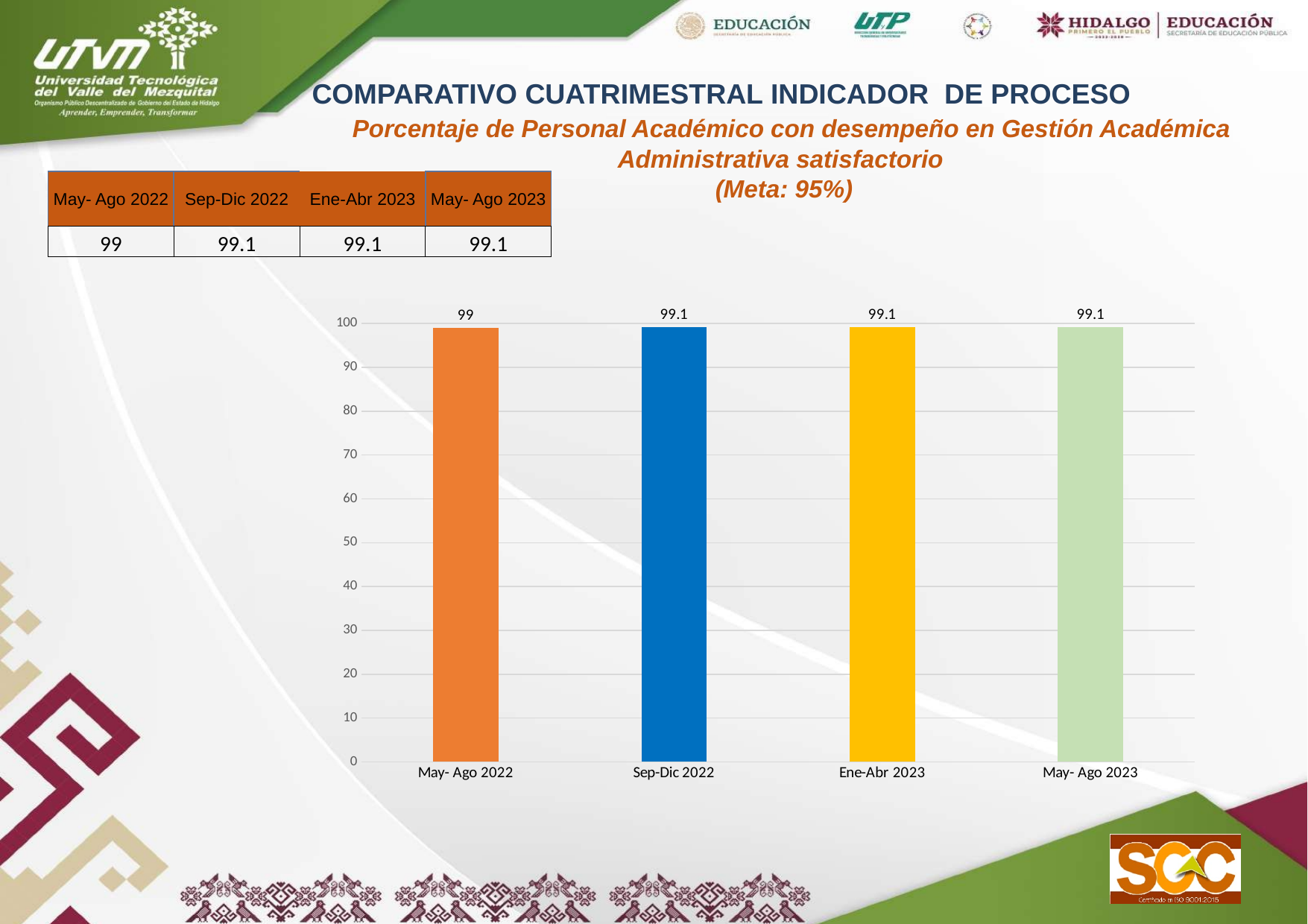
What is the value for Sep-Dic 2022? 99.1 Which is larger, the value for May- Ago 2022 or the value for Sep-Dic 2022? Sep-Dic 2022 Does the value rise or fall from May- Ago 2022 to Sep-Dic 2022? rise What is the value for May- Ago 2022? 99 What colour is the bar for Sep-Dic 2022? blue What is the difference between the values for Sep-Dic 2022 and May- Ago 2022? 0.1 Is the value for Ene-Abr 2023 greater or less than 90? greater How many periods are shown on the x axis of the chart? 4 Which period has the lowest value? May- Ago 2022 What kind of chart is shown on the slide? bar chart What is the value for May- Ago 2023? 99.1 What is the value for Ene-Abr 2023? 99.1